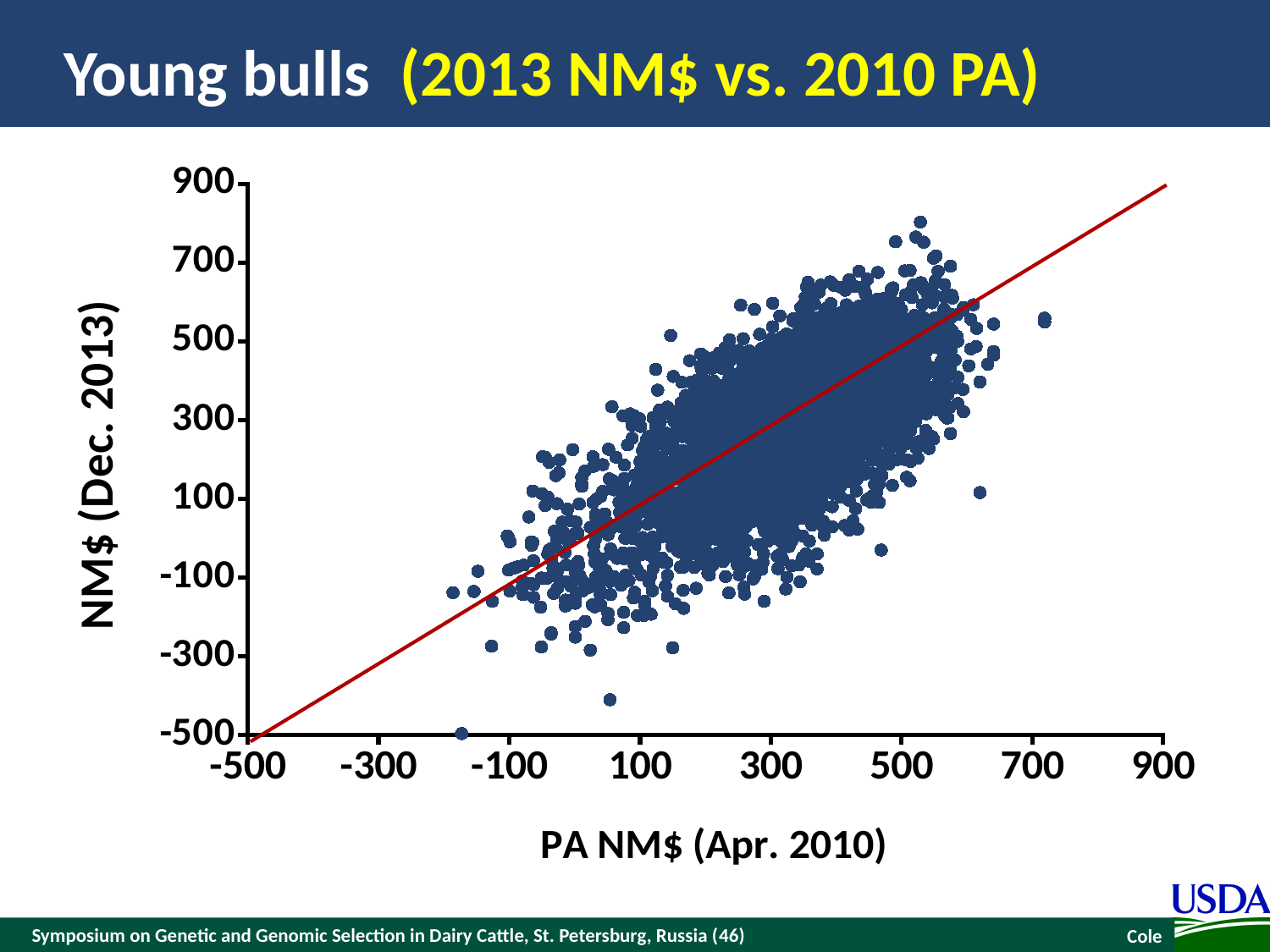
Is the highest plotted point's NM$ (Dec. 2013) value greater or less than 700? greater What is the label of the x axis? PA NM$ (Apr. 2010) What is the spacing between consecutive tick labels on the y axis? 200 What is the label of the y axis? NM$ (Dec. 2013) Do the plotted NM$ (Dec. 2013) values generally rise or fall as PA NM$ (Apr. 2010) increases? rise What kind of chart is shown on the slide? scatter plot What is the highest tick value shown on the x axis? 900 At what y-axis value does the red line start when the x axis is at -500? -500 At what y-axis value does the red line end when the x axis reaches 900? 900 Is the lowest plotted point's NM$ (Dec. 2013) value greater or less than -300? less What is the lowest tick value shown on the y axis? -500